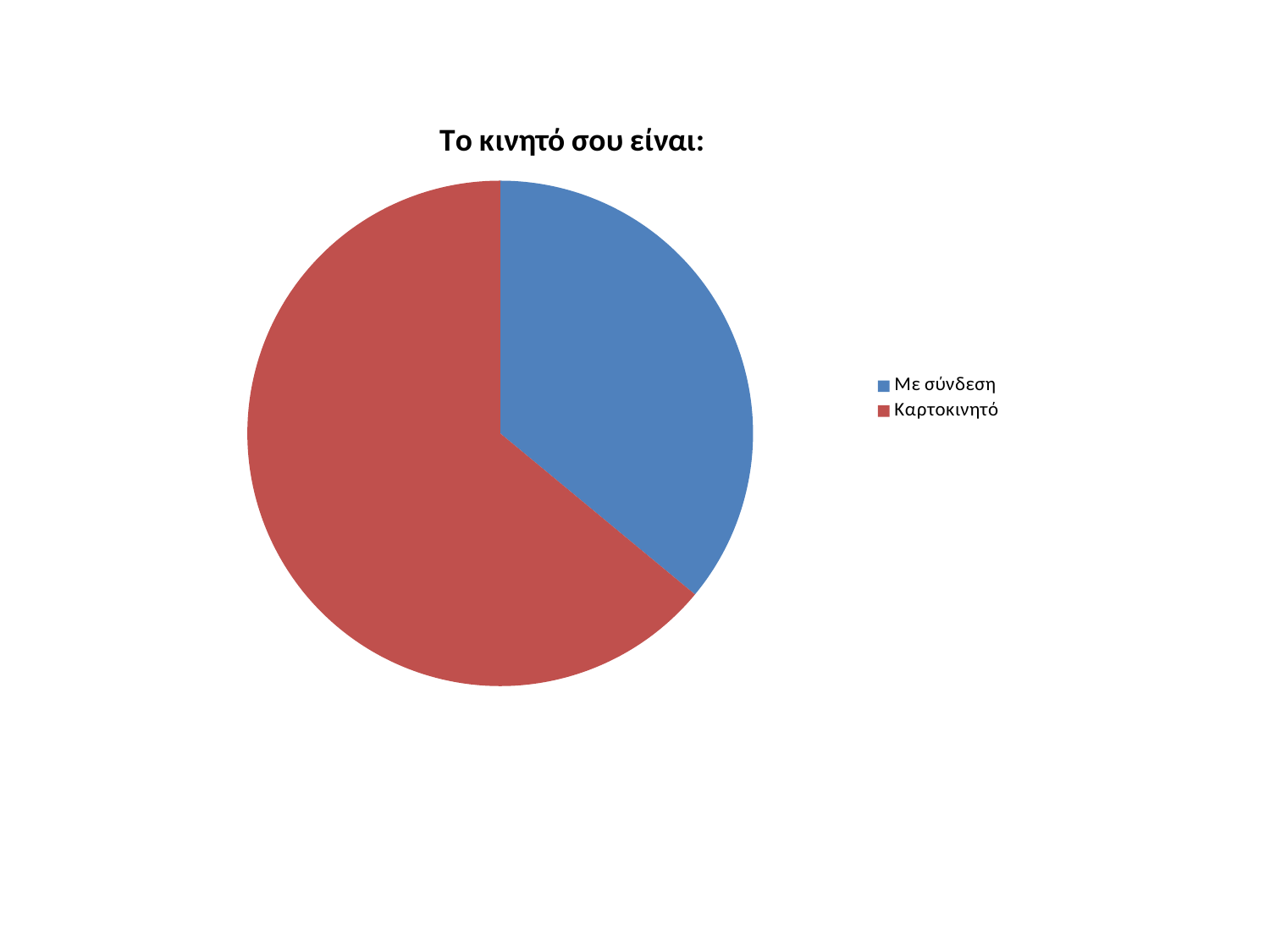
Which category has the smallest slice of the pie? Με σύνδεση Which colour represents Καρτοκινητό in the chart? red Is the share of Με σύνδεση greater or less than half of the pie? less Which category has the largest slice of the pie? Καρτοκινητό What is the title of the chart? Το κινητό σου είναι: Is the share of Καρτοκινητό greater or less than half of the pie? greater How many slices does the pie chart have? 2 How many entries does the legend list? 2 Which slice is larger, Με σύνδεση or Καρτοκινητό? Καρτοκινητό What kind of chart is shown on the slide? pie chart